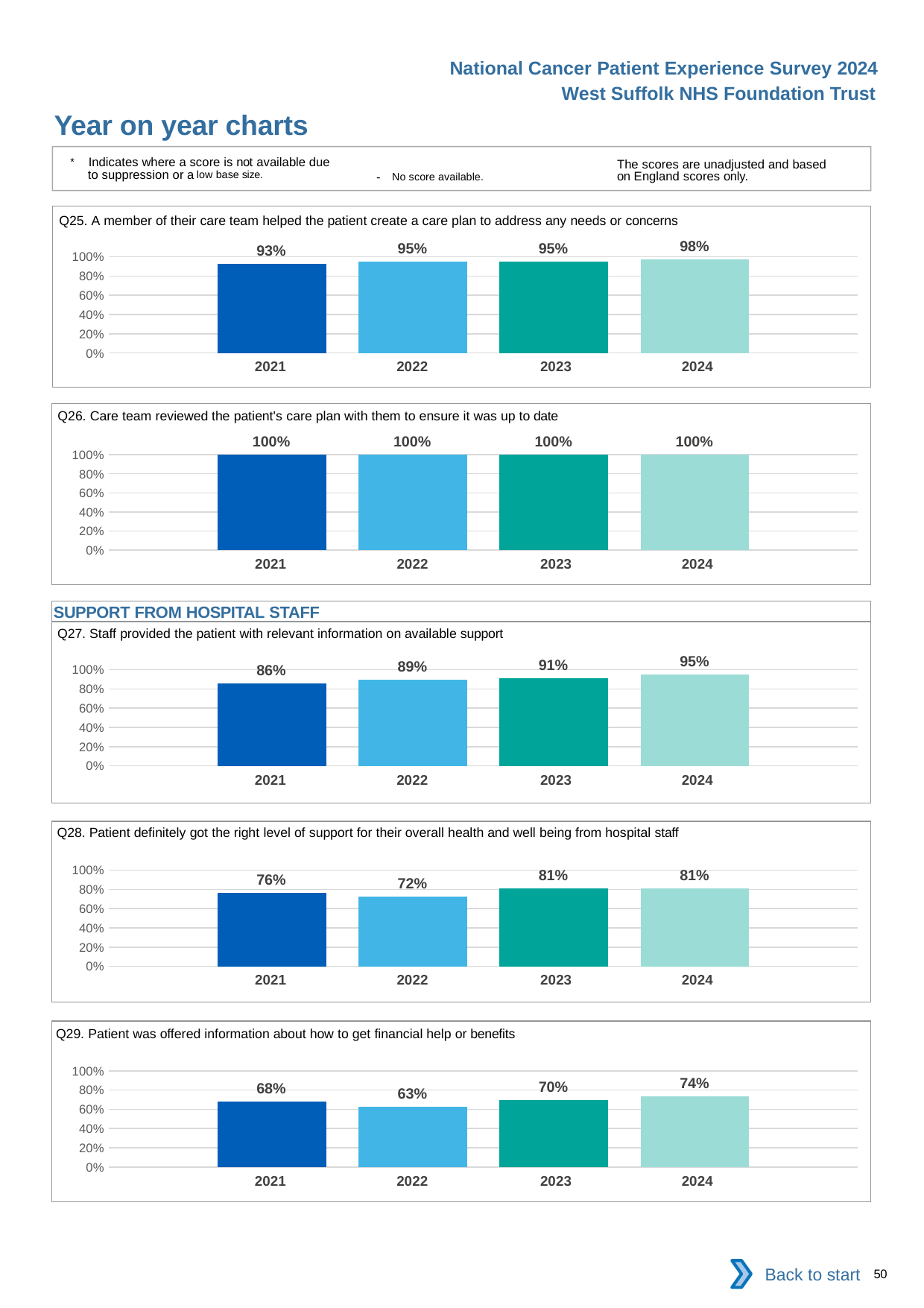
In the Q27 chart, do the values rise or fall from 2021 to 2024? rise In the Q27 chart, what is the difference between the 2024 and 2021 values? 9 percentage points In the Q29 chart, what is the difference between the 2024 and 2022 values? 11 percentage points In the Q25 chart, what is the value for 2024? 98% In the Q25 chart, which year has the lowest value? 2021 In the Q26 chart, what is the value for 2023? 100% What type of chart is used for Q25? bar chart In the Q29 chart, which is larger, the value for 2021 or the value for 2022? 2021 In the Q28 chart, which year has the lowest value? 2022 In the Q28 chart, what is the value for 2023? 81% How many bars are in the Q28 chart? 4 In the Q29 chart, which year has the highest value? 2024